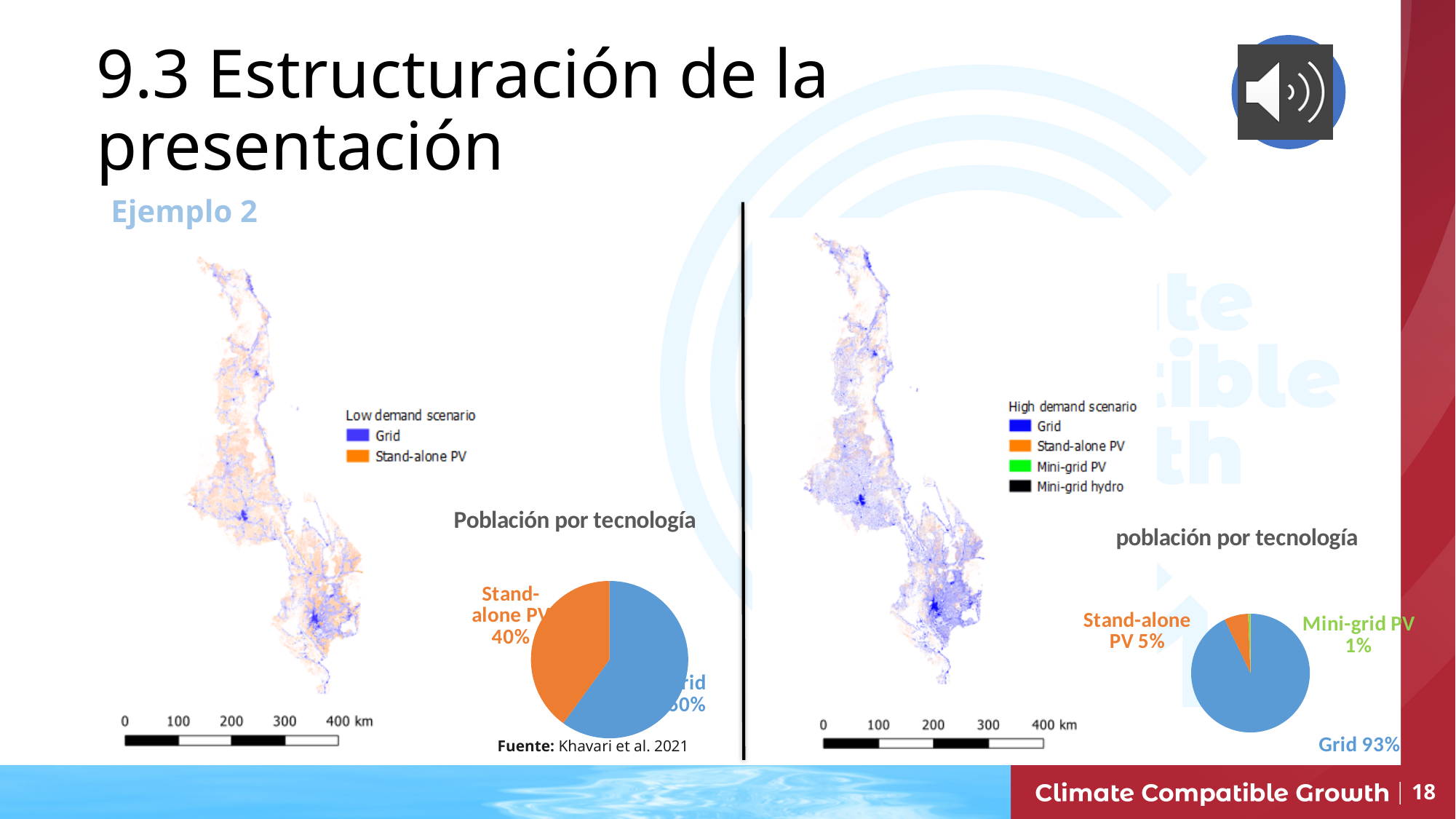
In the right 'población por tecnología' pie chart, what is the difference in percentage points between the Grid share and the Stand-alone PV share? 88 percentage points In the left 'Población por tecnología' pie chart, what share does Stand-alone PV have? 40% In the left 'Población por tecnología' pie chart, which slice is larger, Grid or Stand-alone PV? Grid In the right 'población por tecnología' pie chart, what share does Grid have? 93% In the left 'Población por tecnología' pie chart, what is the difference in percentage points between the Grid share and the Stand-alone PV share? 20 percentage points In the right 'población por tecnología' pie chart, what share does Mini-grid PV have? 1% In the right 'población por tecnología' pie chart, which technology has the largest slice? Grid In the right 'población por tecnología' pie chart, which slice is larger, Stand-alone PV or Mini-grid PV? Stand-alone PV What kind of chart is the 'Población por tecnología' chart on the left side of the slide? pie chart What source is cited below the left 'Población por tecnología' pie chart? Khavari et al. 2021